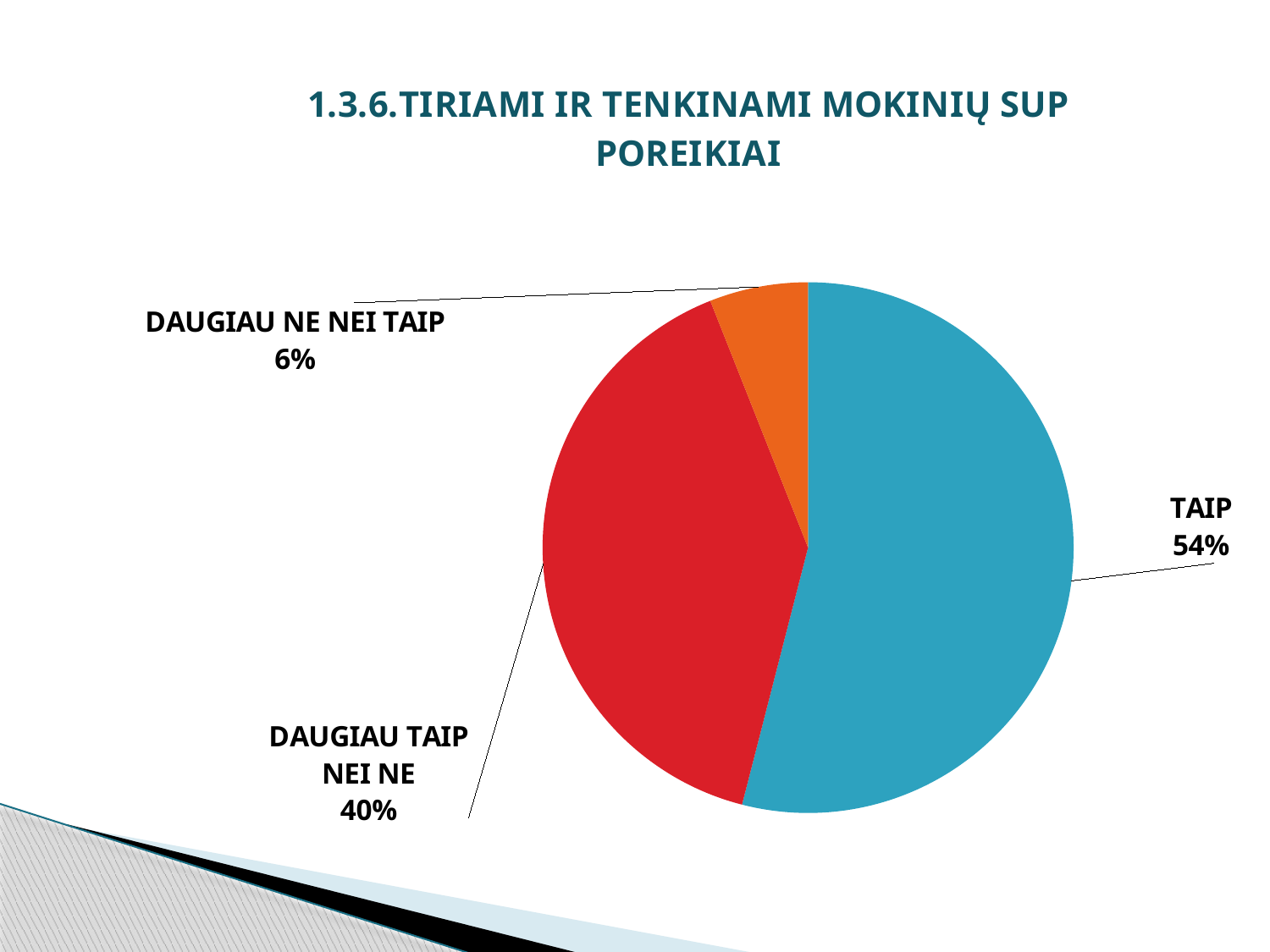
Which is larger, the share for TAIP or the share for DAUGIAU TAIP NEI NE? TAIP What is the title of the chart? 1.3.6.TIRIAMI IR TENKINAMI MOKINIŲ SUP POREIKIAI How many slices does the pie chart have? 3 Which slice of the pie is the smallest? DAUGIAU NE NEI TAIP What share of the pie does DAUGIAU NE NEI TAIP represent? 6% What colour is the TAIP slice of the pie? blue What kind of chart is shown on the slide? pie chart What is the difference in percentage points between DAUGIAU TAIP NEI NE and DAUGIAU NE NEI TAIP? 34 What share of the pie does TAIP represent? 54% Which slice of the pie is the largest? TAIP What is the difference in percentage points between TAIP and DAUGIAU TAIP NEI NE? 14 What share of the pie does DAUGIAU TAIP NEI NE represent? 40%